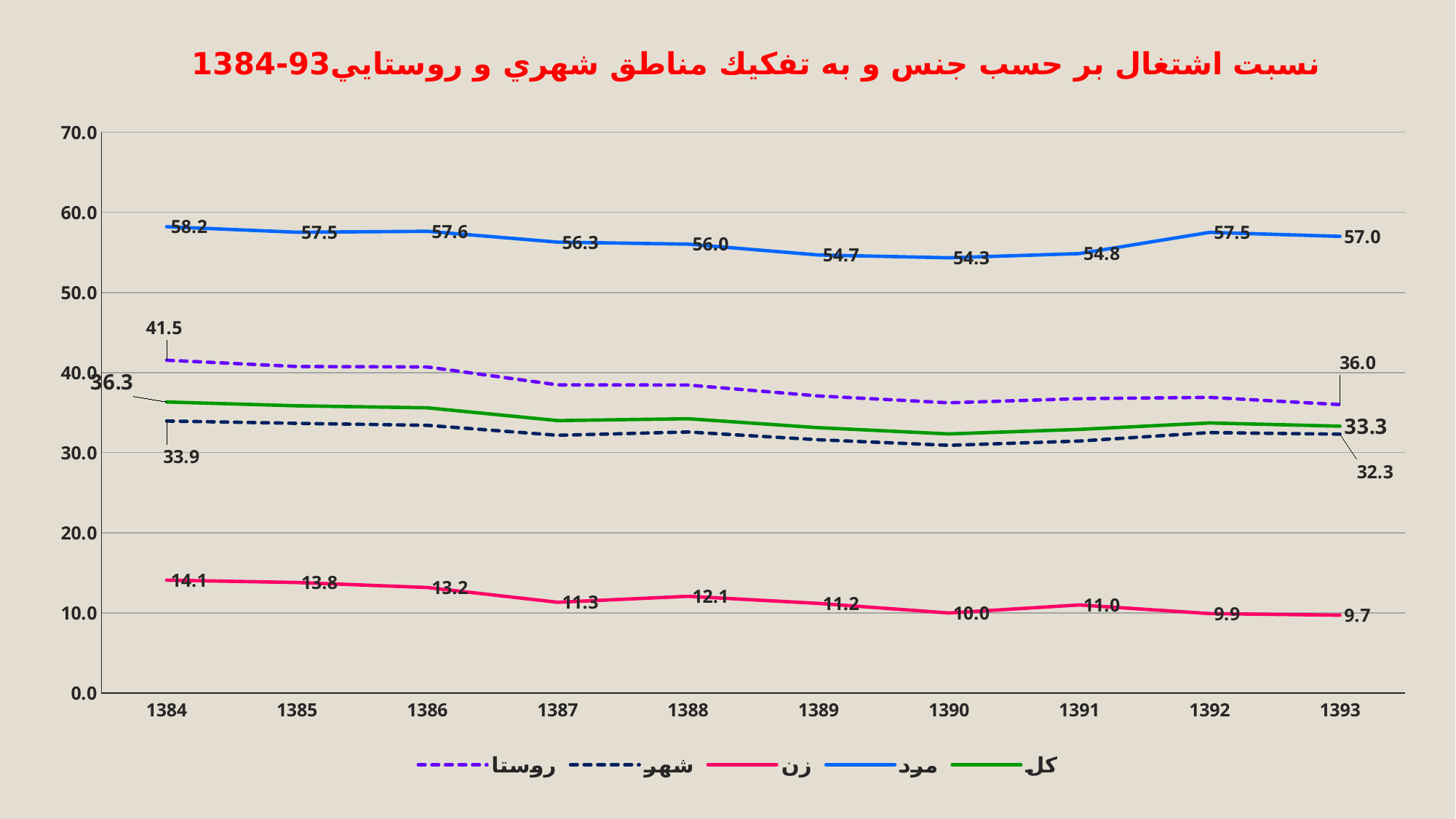
In which year is the زن (women) series at its highest? 1384 What is the value for روستا (rural) in 1384? 41.5 How many years are shown on the x axis? 10 What is the difference between the مرد (men) values in 1384 and 1393? 1.2 What is the value for شهر (urban) in 1393? 32.3 What is the value for زن (women) in 1393? 9.7 Is the value for روستا (rural) in 1388 greater or less than 30.0? greater Which is larger, the زن (women) value in 1388 or in 1389? 1388 In which year is the مرد (men) series at its lowest? 1390 How many series does the legend list? 5 What kind of chart is shown on the slide? line chart What is the value for مرد (men) in 1384? 58.2